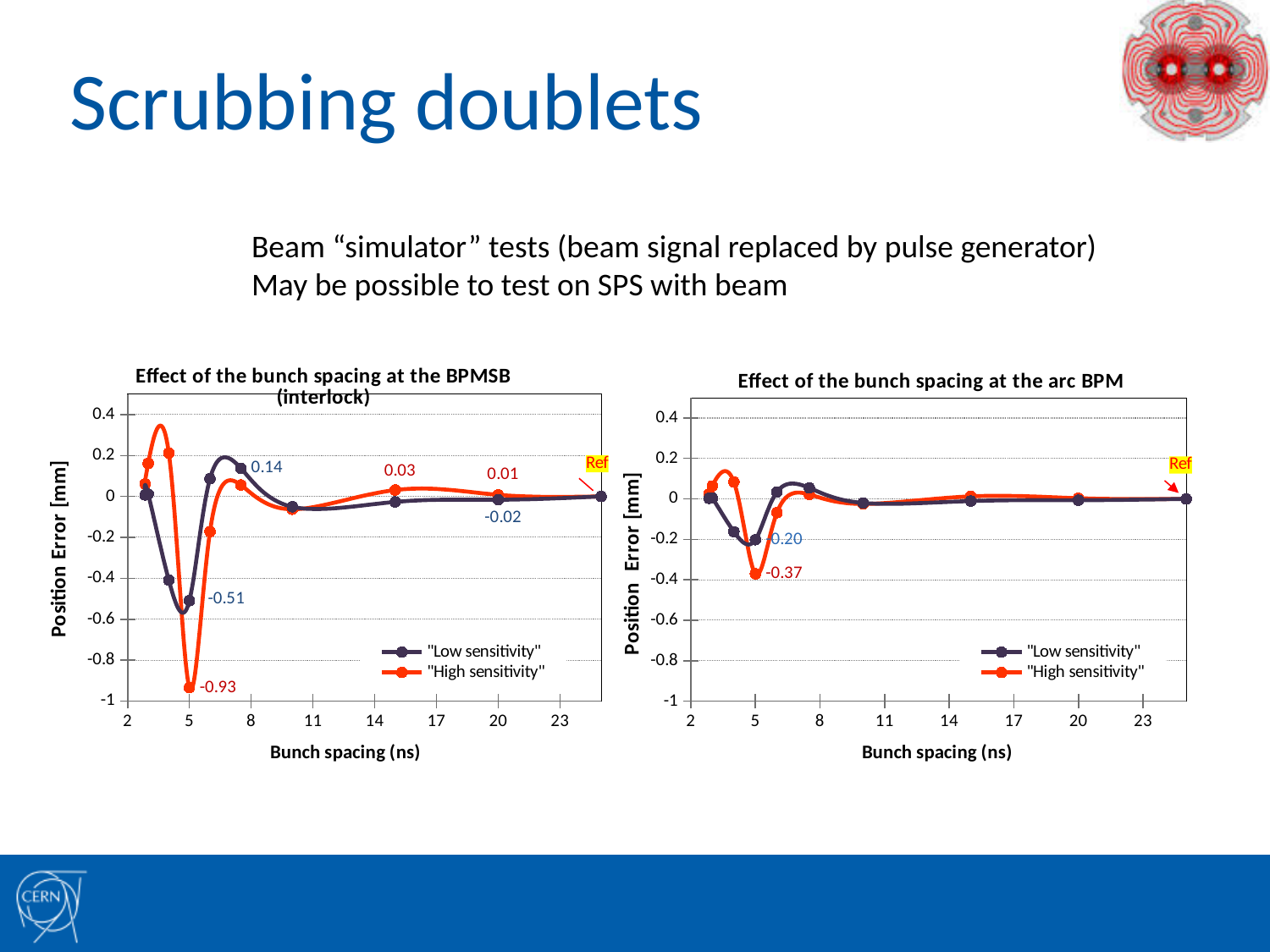
In the 'Effect of the bunch spacing at the BPMSB (interlock)' chart, what is the largest positive labelled value shown? 0.14 In the 'Effect of the bunch spacing at the arc BPM' chart, what is the lowest labelled value of the 'High sensitivity' series? -0.37 In the 'Effect of the bunch spacing at the BPMSB (interlock)' chart, what is the difference between the labelled minima of the 'Low sensitivity' (-0.51) and 'High sensitivity' (-0.93) series? 0.42 What type of chart is used in the 'Effect of the bunch spacing at the BPMSB (interlock)' chart? Line chart What is the x-axis title of the 'Effect of the bunch spacing at the arc BPM' chart? Bunch spacing (ns) How many series does the legend of the 'Effect of the bunch spacing at the arc BPM' chart list? 2 In the 'Effect of the bunch spacing at the arc BPM' chart, what is the difference between the labelled minima of the 'Low sensitivity' (-0.20) and 'High sensitivity' (-0.37) series? 0.17 In the 'Effect of the bunch spacing at the BPMSB (interlock)' chart, what is the lowest labelled value of the 'Low sensitivity' series? -0.51 What is the y-axis title of the 'Effect of the bunch spacing at the BPMSB (interlock)' chart? Position Error [mm] In the 'Effect of the bunch spacing at the BPMSB (interlock)' chart, what is the lowest labelled value of the 'High sensitivity' series? -0.93 In the 'Effect of the bunch spacing at the BPMSB (interlock)' chart, which series reaches the lower minimum position error, 'Low sensitivity' or 'High sensitivity'? High sensitivity In the 'Effect of the bunch spacing at the arc BPM' chart, what is the lowest labelled value of the 'Low sensitivity' series? -0.20